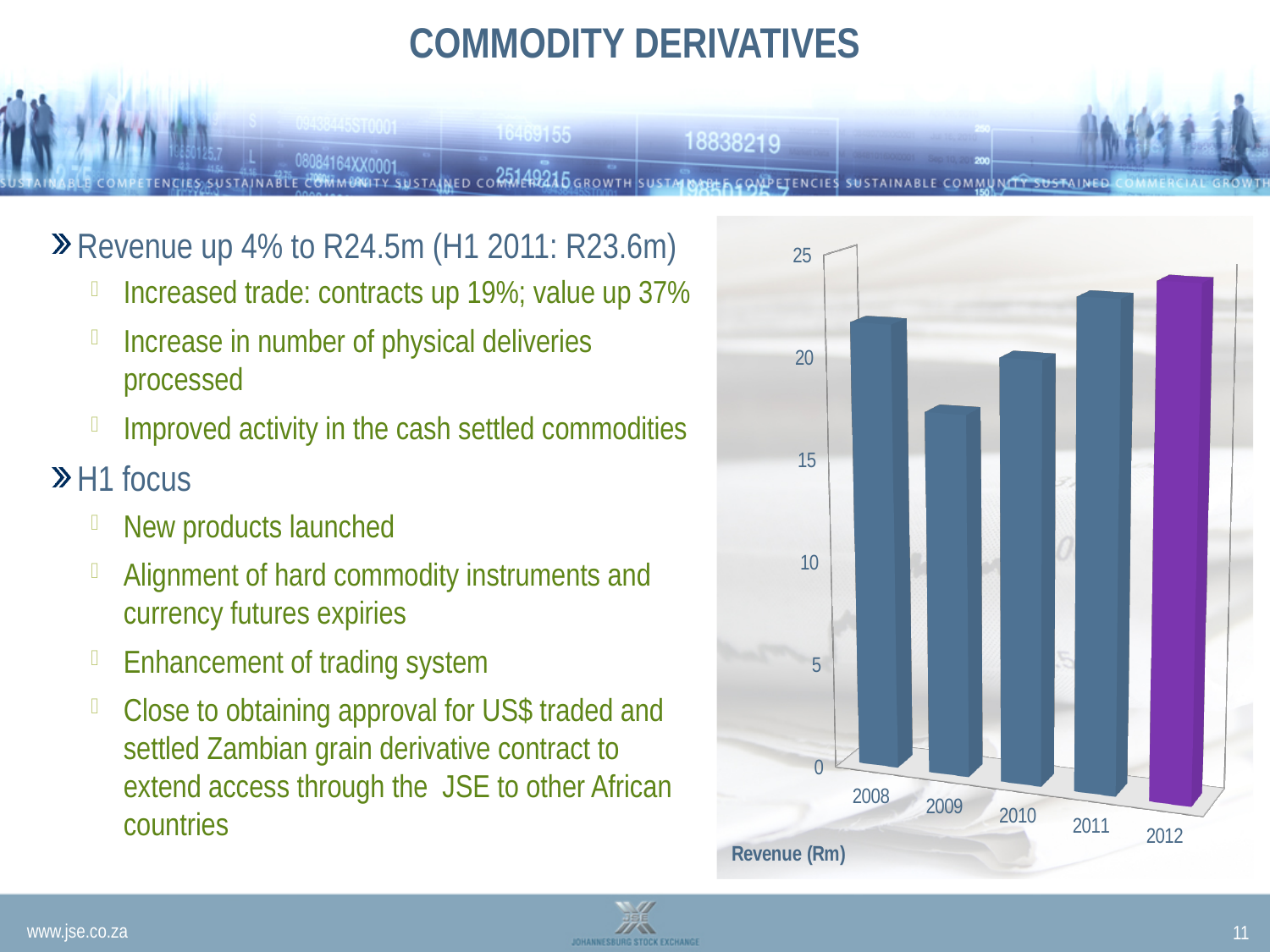
Do the revenue values rise or fall from 2009 to 2012? Rise Is the revenue for 2012 greater or less than 25? less Is the revenue for 2008 greater or less than 20? greater Is the revenue for 2009 greater or less than 20? less Which year has the larger revenue, 2008 or 2009? 2008 Which year has the highest revenue in the chart? 2012 How many years are shown on the x axis of the chart? 5 Which year has the larger revenue, 2010 or 2011? 2011 Which year has the lowest revenue in the chart? 2009 What label is shown beneath the chart describing the plotted measure? Revenue (Rm) What kind of chart is shown on the slide? Bar chart